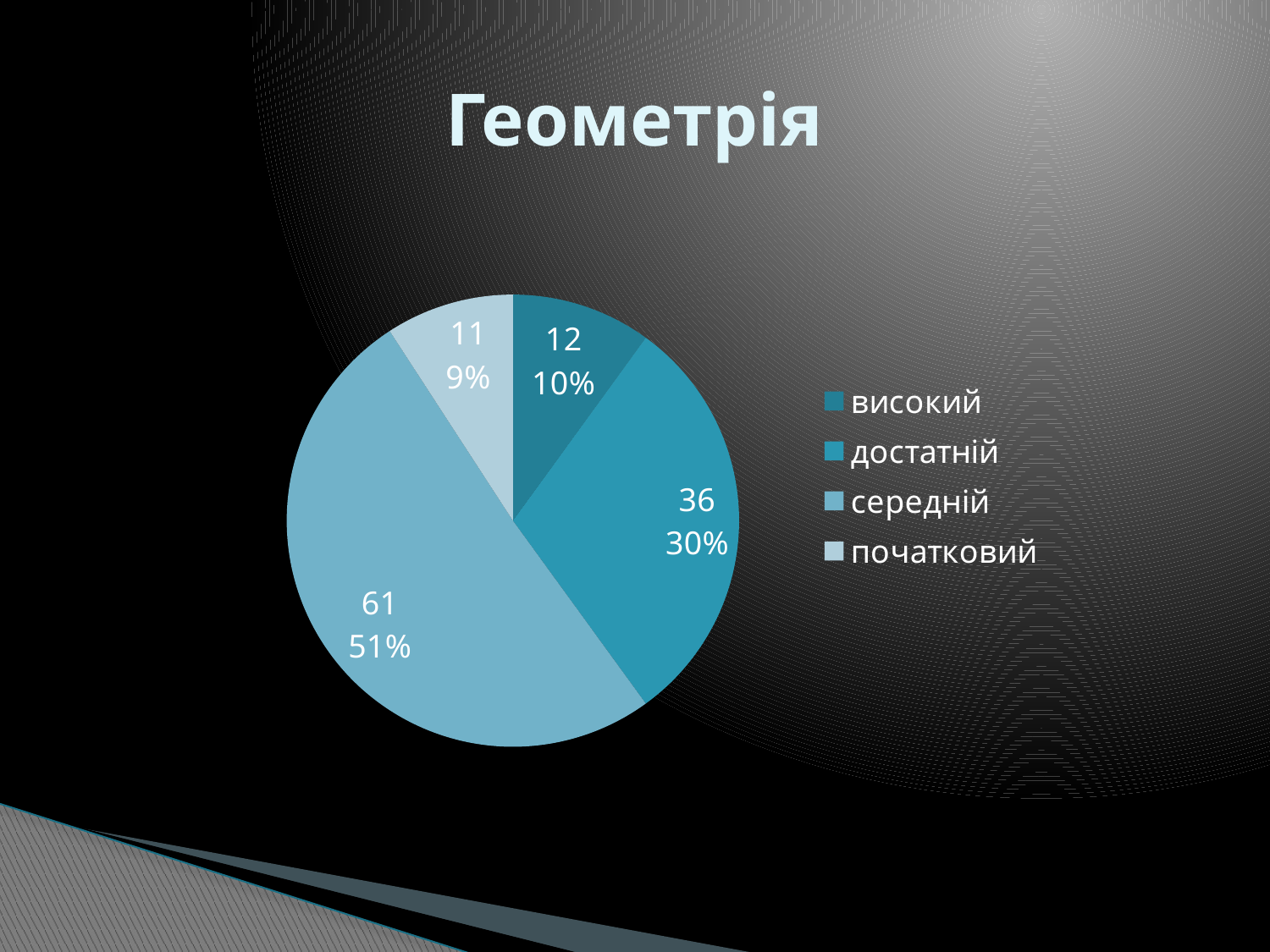
Which is larger, the value for високий or the value for початковий? високий What share of the pie does середній take? 51% What is the value for достатній? 36 Which category has the smallest slice? початковий Which category has the largest slice? середній What share of the pie does достатній take? 30% What is the value for початковий? 11 What is the difference between the values for середній and достатній? 25 How many categories does the legend list? 4 What kind of chart is shown on the slide? pie chart What is the value for високий? 12 What is the value for середній? 61